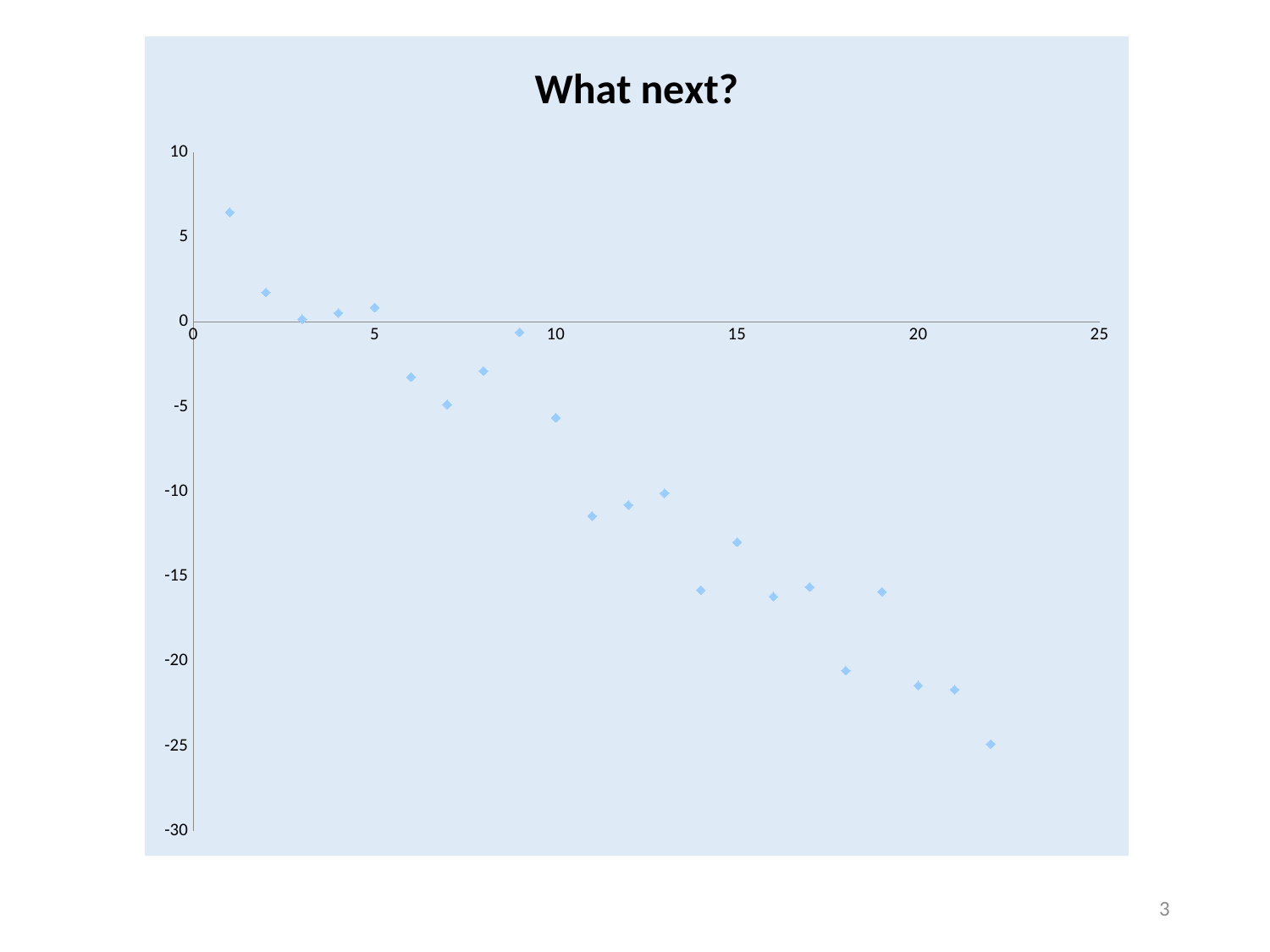
Is the value at x = 7 greater or less than -10? greater At which x value is the lowest plotted point? 22 What is the lowest value shown on the vertical axis? -30 Is the value at x = 22 greater or less than -20? less Is the value at x = 1 greater or less than 5? greater What is the title of the chart? What next? Do the plotted values generally rise or fall as x increases? fall How many data points are plotted on the chart? 22 Which is larger, the value at x = 2 or the value at x = 18? x = 2 At which x value is the highest plotted point? 1 What kind of chart is shown on the slide? scatter chart